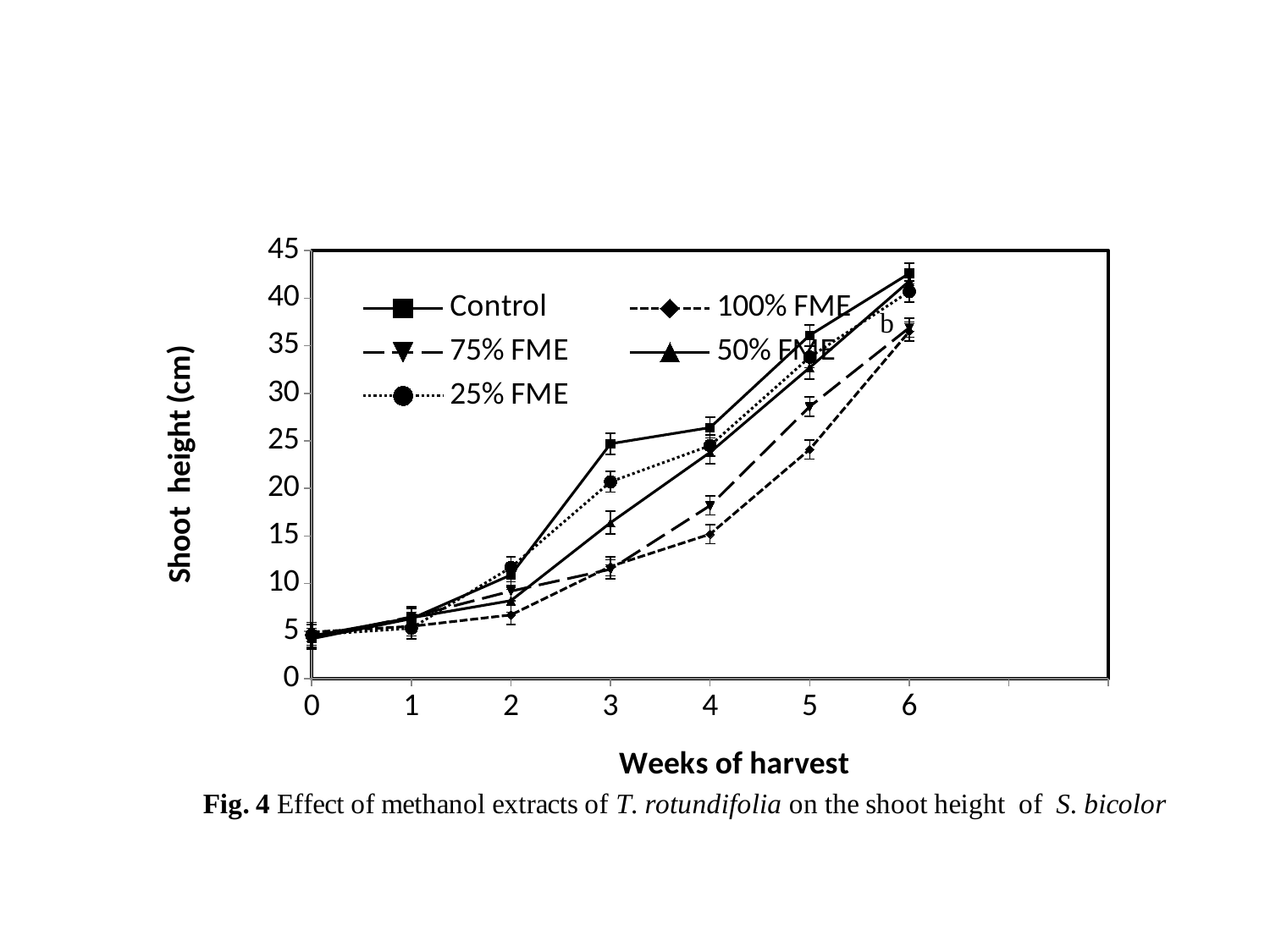
Is the shoot height for 75% FME at week 5 greater or less than 25? greater At week 3, which has the larger shoot height, Control or 100% FME? Control What is the title of the x axis? Weeks of harvest At week 4, which series has the lowest shoot height? 100% FME At week 5, which has the larger shoot height, 75% FME or 100% FME? 75% FME How many series does the legend list? 5 Is the shoot height for Control at week 3 greater or less than 20? greater Is the shoot height for 100% FME at week 5 greater or less than 30? less Does the shoot height for Control rise or fall from week 0 to week 6? rise How many weeks of harvest are plotted along the x axis? 7 What kind of chart is shown on the slide? line chart